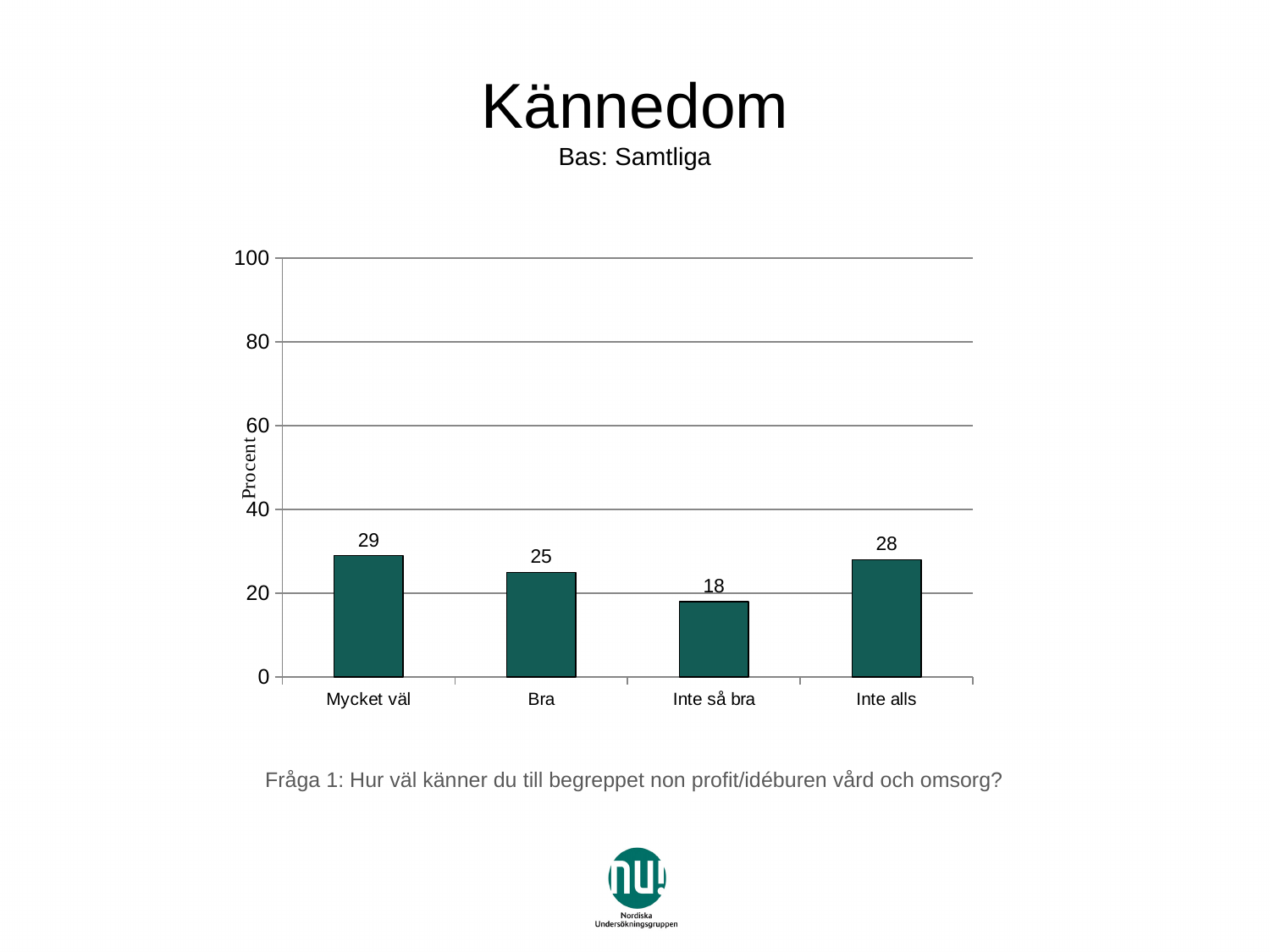
What is the value for "Bra"? 25 What is the difference between the values for "Mycket väl" and "Inte så bra"? 11 Which is larger, the value for "Bra" or the value for "Inte alls"? Inte alls Is the value for "Inte så bra" greater or less than 20? less What is the value for "Inte så bra"? 18 What kind of chart is shown on the slide? bar chart What is the label of the y axis? Procent What is the value for "Mycket väl"? 29 What is the value for "Inte alls"? 28 Which category has the highest value? Mycket väl Which category has the lowest value? Inte så bra How many categories are shown on the x axis? 4